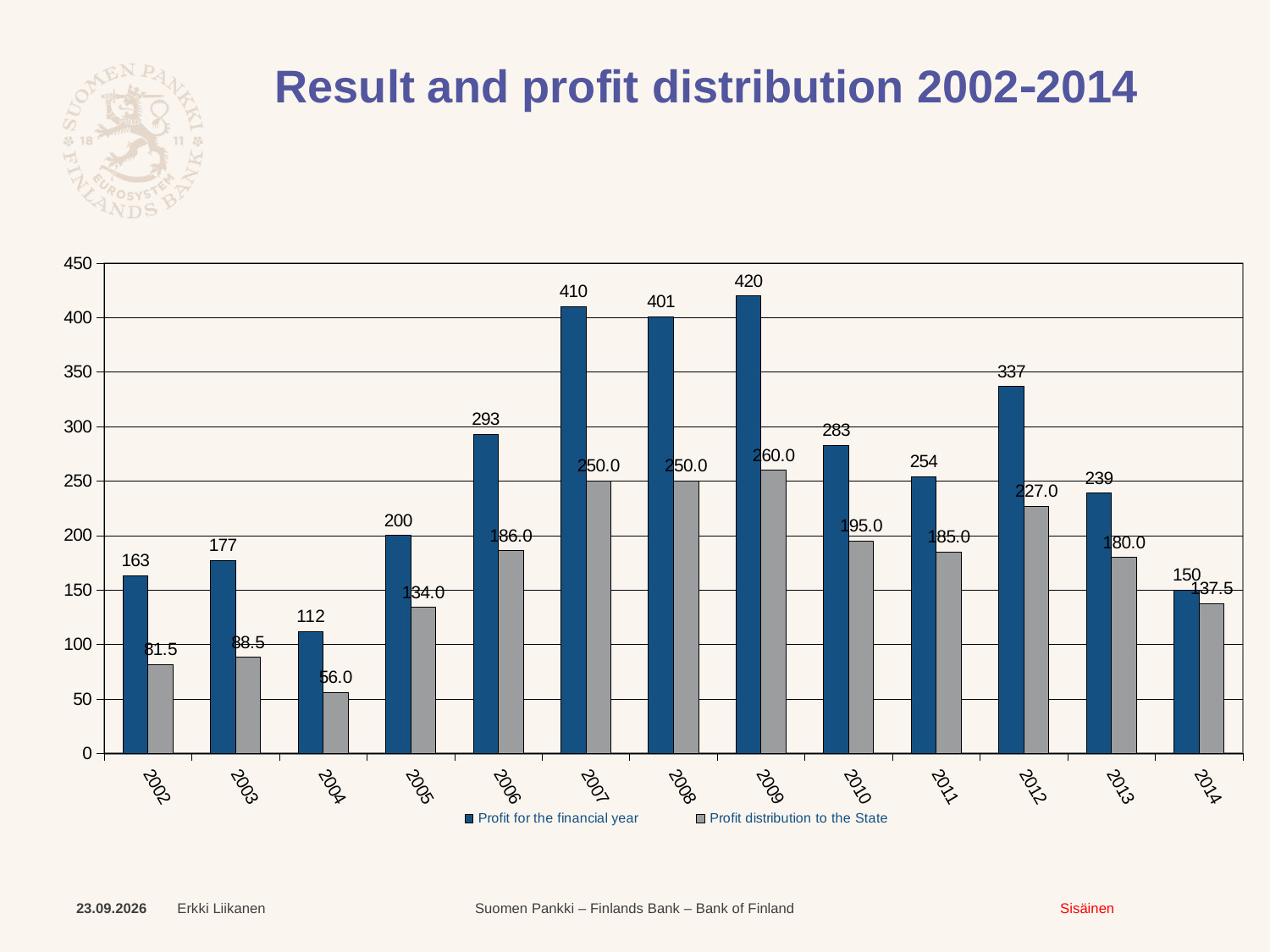
How many series does the legend list? 2 In which year was the profit for the financial year highest? 2009 What was the profit distribution to the State in 2005? 134.0 What was the profit for the financial year in 2009? 420 What is the difference between the profit for the financial year and the profit distribution to the State in 2012? 110.0 What is the title of the chart? Result and profit distribution 2002-2014 Which was larger, the profit for the financial year in 2007 or in 2008? 2007 What kind of chart is shown on the slide? Bar chart Is the profit for the financial year in 2006 greater or less than 250? greater In which year was the profit distribution to the State lowest? 2004 How many years are shown on the x axis? 13 Did the profit for the financial year rise or fall from 2012 to 2014? Fall